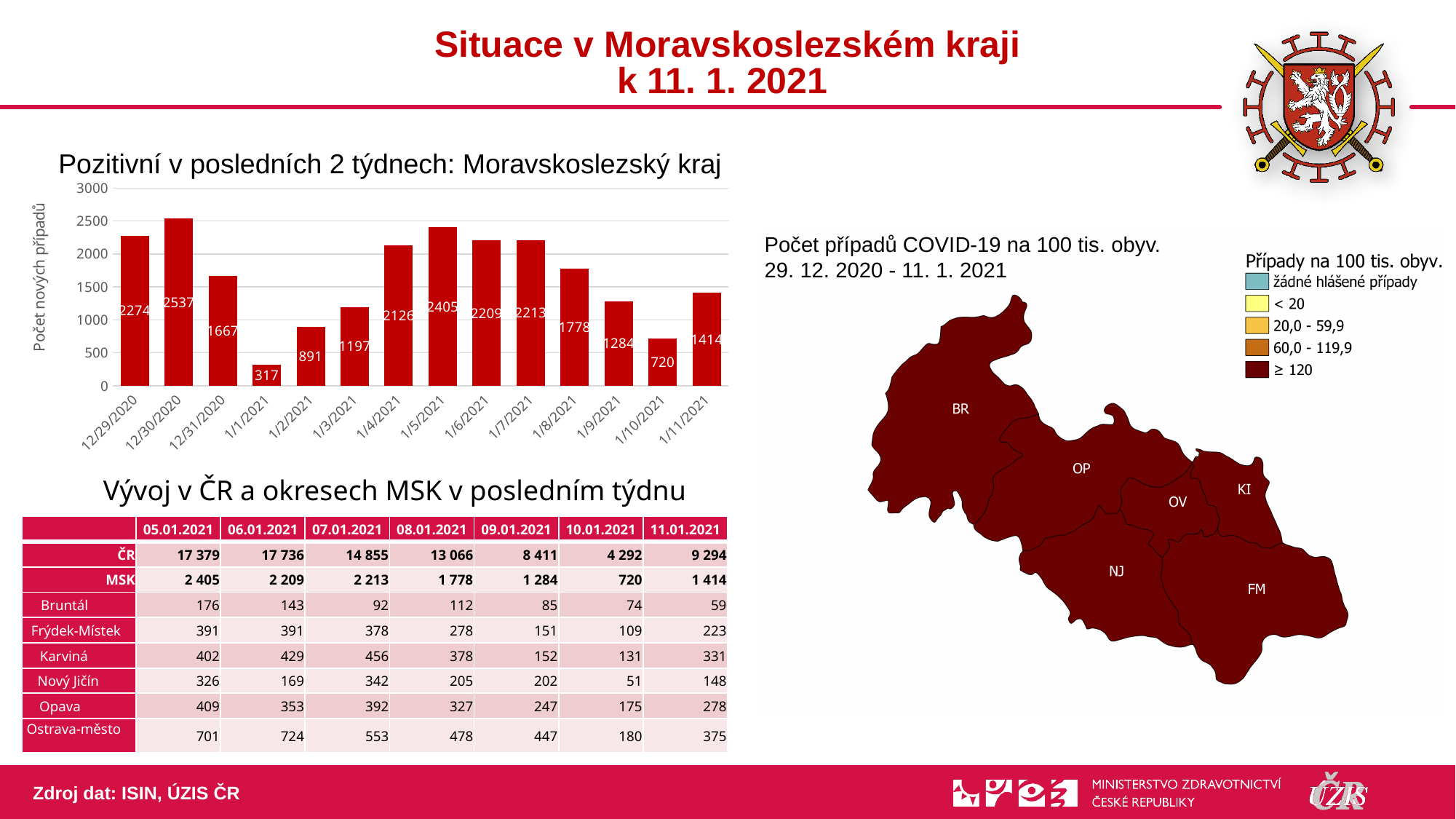
Which date has the lowest value in the bar chart? 1/1/2021 In the bar chart, do the values rise or fall from 1/7/2021 to 1/10/2021? fall Which date has the highest value in the bar chart? 12/30/2020 How many dates (bars) are shown in the bar chart? 14 In the bar chart, which is larger: the value for 1/4/2021 or the value for 1/8/2021? 1/4/2021 In the bar chart, what is the value for 1/5/2021? 2405 In the bar chart, what is the difference between the values for 12/30/2020 and 1/1/2021? 2220 What type of chart is used for 'Pozitivní v posledních 2 týdnech: Moravskoslezský kraj'? bar chart In the bar chart, what is the value for 12/29/2020? 2274 In the bar chart, is the value for 1/9/2021 greater or less than 1000? greater In the bar chart, what is the value for 1/11/2021? 1414 In the bar chart, what is the difference between the values for 1/11/2021 and 1/10/2021? 694